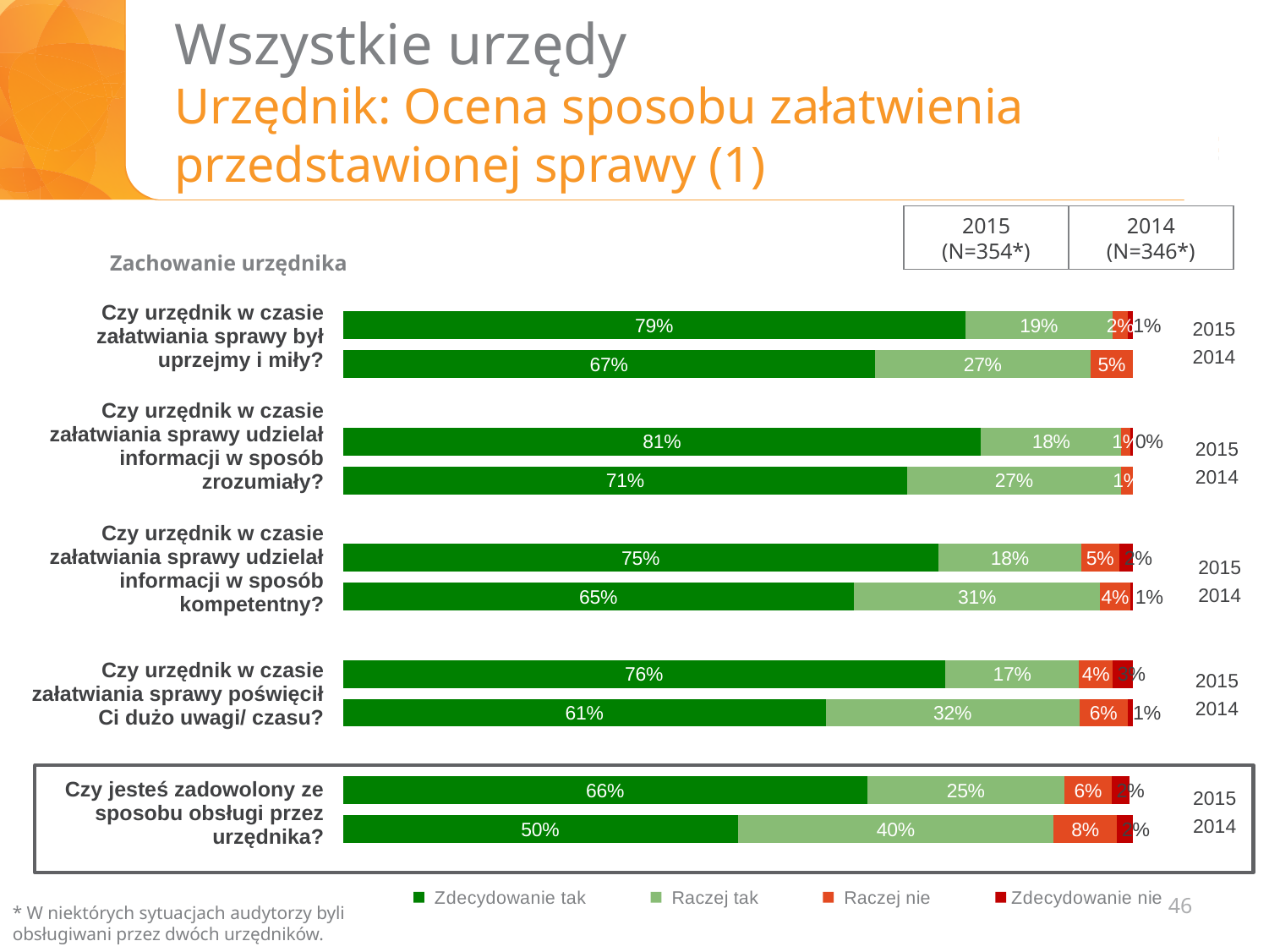
How many questions (categories) are shown in the chart? 5 What type of chart is shown on the slide? Stacked bar chart Which question had the lowest "Zdecydowanie tak" share in 2014? Czy jesteś zadowolony ze sposobu obsługi przez urzędnika? Which question had the highest "Zdecydowanie tak" share in 2015? Czy urzędnik w czasie załatwiania sprawy udzielał informacji w sposób zrozumiały? What percentage answered "Raczej nie" in 2014 to the question "Czy urzędnik w czasie załatwiania sprawy poświęcił Ci dużo uwagi/ czasu?"? 6% For "Czy urzędnik w czasie załatwiania sprawy udzielał informacji w sposób kompetentny?", which year had the larger "Raczej tak" share, 2015 or 2014? 2014 How many series does the legend list? 4 What percentage answered "Zdecydowanie tak" in 2015 to the question "Czy urzędnik w czasie załatwiania sprawy był uprzejmy i miły?"? 79% What percentage answered "Raczej tak" in 2014 to the question "Czy jesteś zadowolony ze sposobu obsługi przez urzędnika?"? 40% What is the sample size (N) for 2015 shown on the slide? 354 By how many percentage points did the "Zdecydowanie tak" share for "Czy jesteś zadowolony ze sposobu obsługi przez urzędnika?" change from 2014 to 2015? 16 percentage points What is the combined share of "Zdecydowanie tak" and "Raczej tak" in 2014 for "Czy urzędnik w czasie załatwiania sprawy był uprzejmy i miły?"? 94%